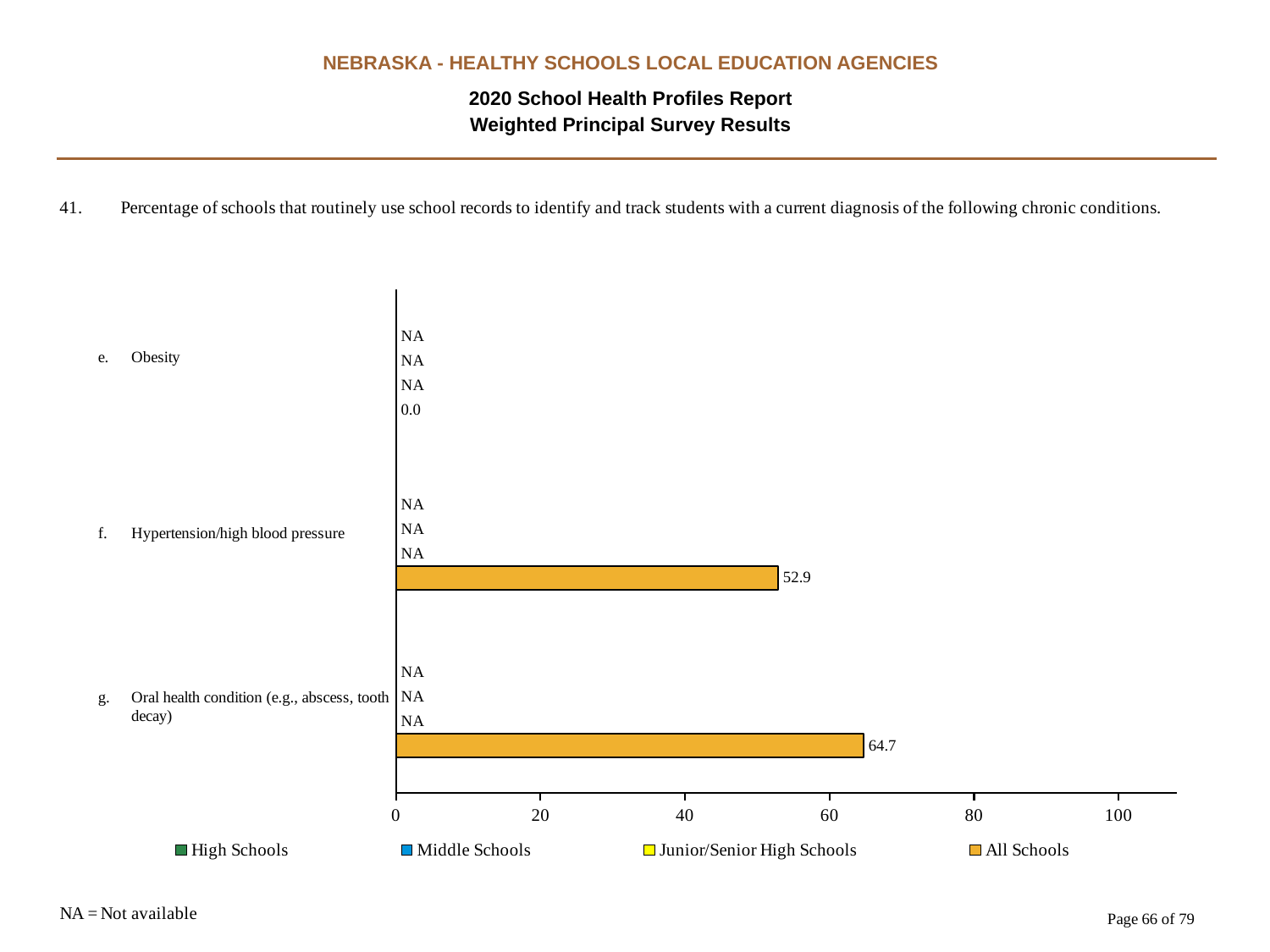
Is the All Schools value for Hypertension/high blood pressure greater or less than 60? less Which condition has the highest All Schools value? Oral health condition (e.g., abscess, tooth decay) How many series does the legend list? 4 What is the High Schools value for Obesity? NA What is the difference between the All Schools values for Oral health condition and Hypertension/high blood pressure? 11.8 What is the All Schools value for Oral health condition (e.g., abscess, tooth decay)? 64.7 How many chronic conditions are listed on the chart? 3 What kind of chart is shown on the slide? bar chart Which has a larger All Schools value: Hypertension/high blood pressure or Oral health condition? Oral health condition What is the All Schools value for Hypertension/high blood pressure? 52.9 What is the All Schools value for Obesity? 0.0 Which condition has the lowest All Schools value? Obesity